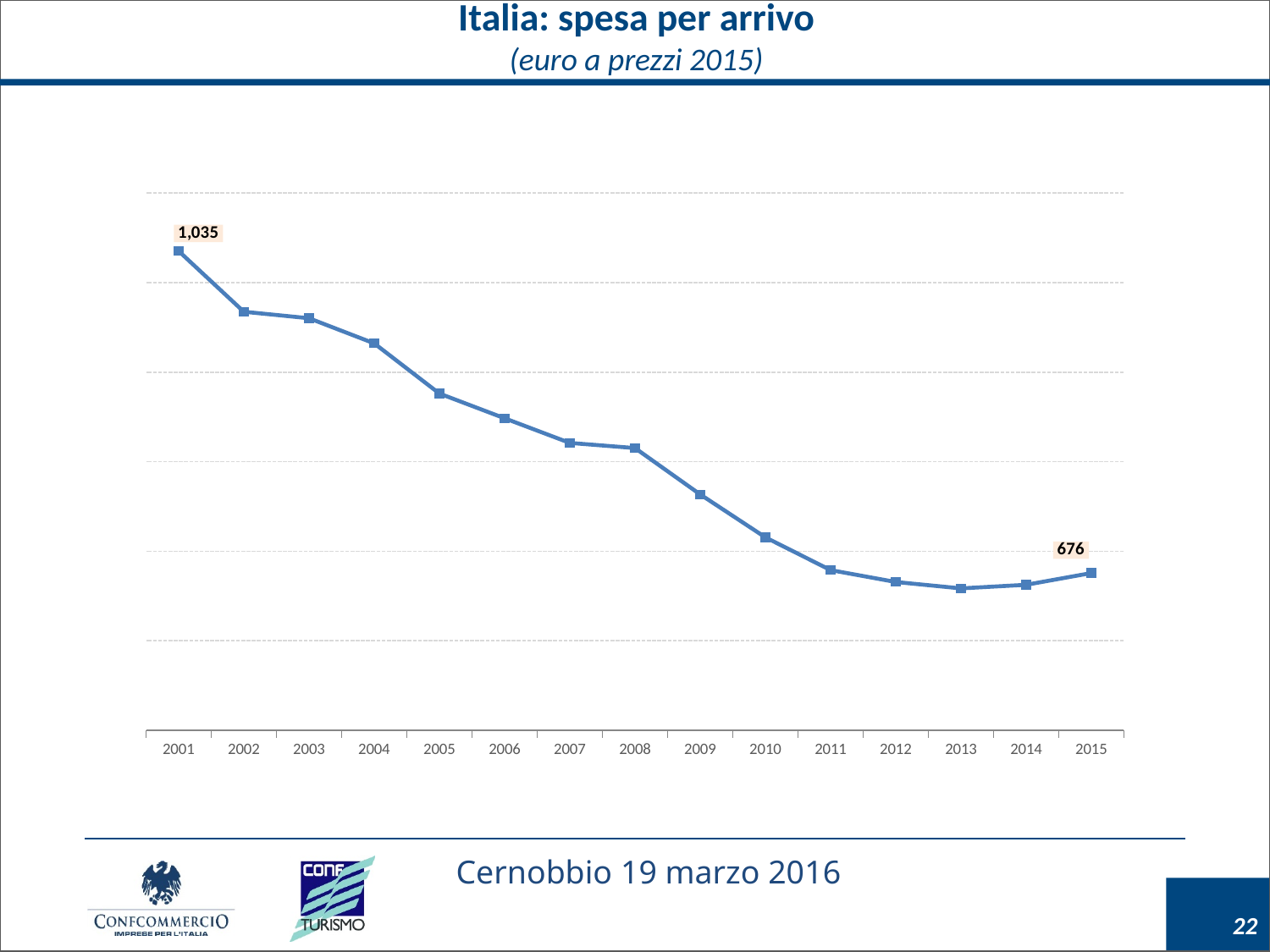
Which year has the highest value? 2001 In what unit are the values expressed, according to the subtitle? euro a prezzi 2015 Do the values generally rise or fall from 2001 to 2015? Fall What is the difference between the value for 2001 and the value for 2015? 359 Which is larger, the value for 2009 or the value for 2011? 2009 How many years are plotted on the x axis? 15 What is the title of the chart? Italia: spesa per arrivo What kind of chart is shown on the slide? Line chart Which is larger, the value for 2005 or the value for 2010? 2005 What is the value for 2001? 1,035 Which is larger, the value for 2002 or the value for 2006? 2002 What is the value for 2015? 676